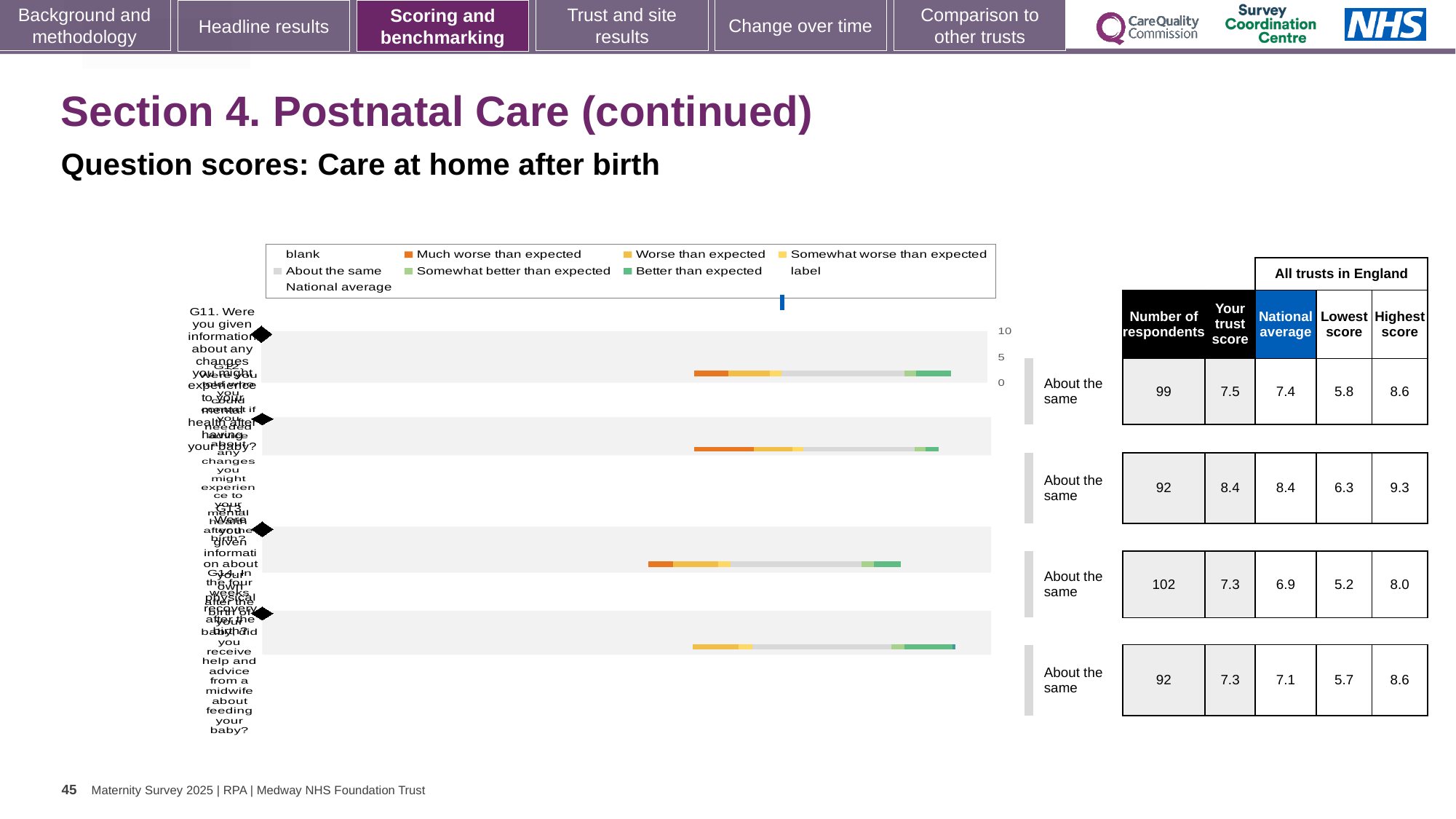
In the table beside the chart, which row has the largest number of respondents? the third row (102) How many horizontal bars are plotted in the chart? 4 What benchmark label is shown next to each of the four bars? About the same What colour does the legend use for "Better than expected"? green What colour does the legend use for "Much worse than expected"? orange In the table beside the chart, what is the highest score for the second row? 9.3 In the table beside the chart, what is the lowest score for the third row? 5.2 What is the highest value shown on the chart's numeric axis? 10 In the table beside the chart, for the third row, which is larger: your trust score or the national average? your trust score (7.3) In the table beside the chart, what is the number of respondents for the first (top) row? 99 What kind of chart is shown on the slide? bar chart In the table beside the chart, what is the difference between your trust score and the national average for the third row? 0.4